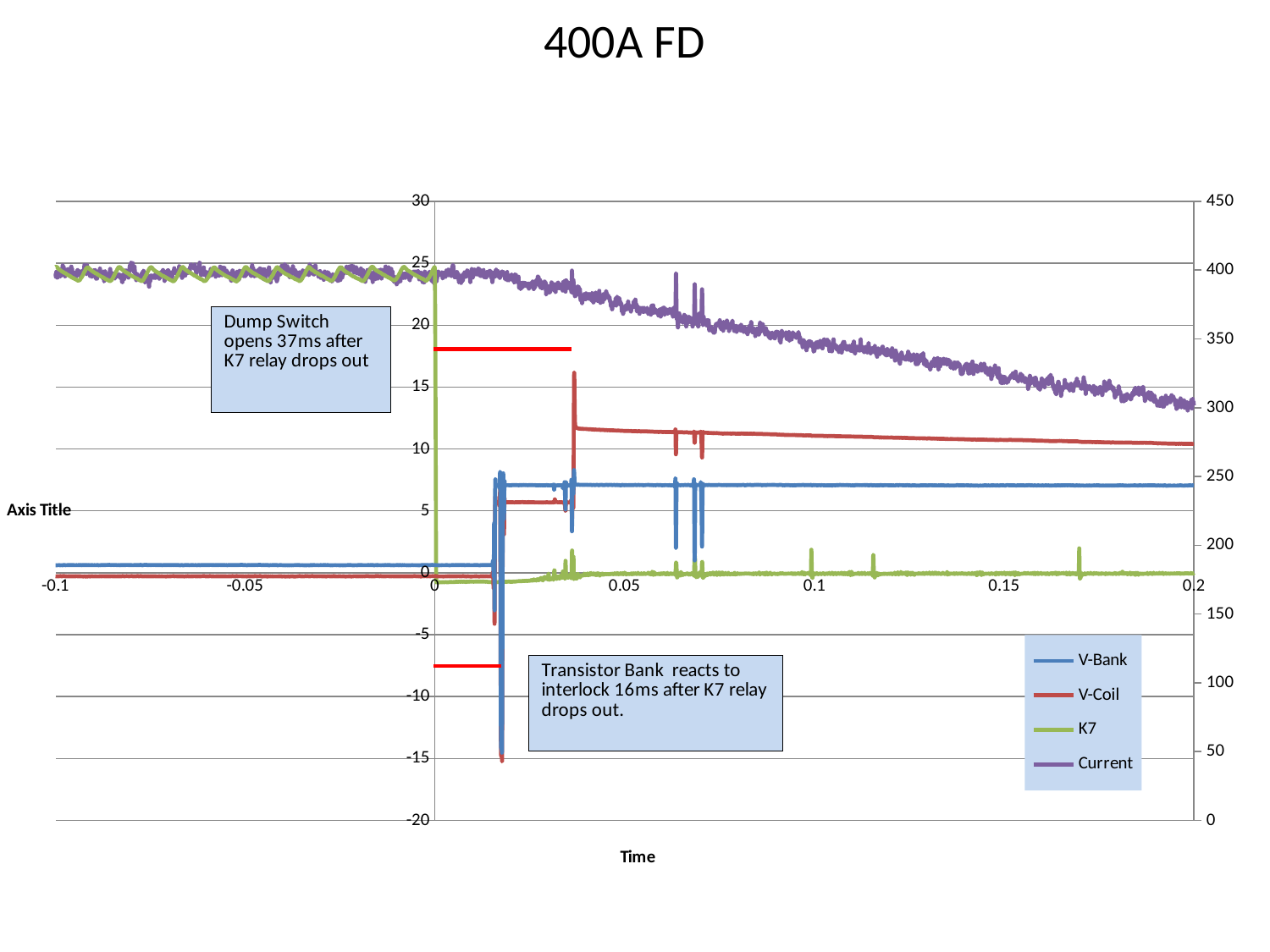
What is the title of the chart? 400A FD Does the K7 series rise or fall sharply at time 0? fall How many series does the legend list? 4 What kind of chart is shown on the slide? line chart Is the value of the V-Bank series at time 0.15 on the left axis greater or less than 5? greater At time 0.15, which series is higher on the left axis, V-Bank or V-Coil? V-Coil Is the value of the V-Coil series at time 0.15 on the left axis greater or less than 15? less Which series is drawn in purple according to the legend? Current Is the value of the Current series at time 0 on the right axis greater or less than 350? greater Does the Current series rise or fall as time increases from 0 to 0.2? fall